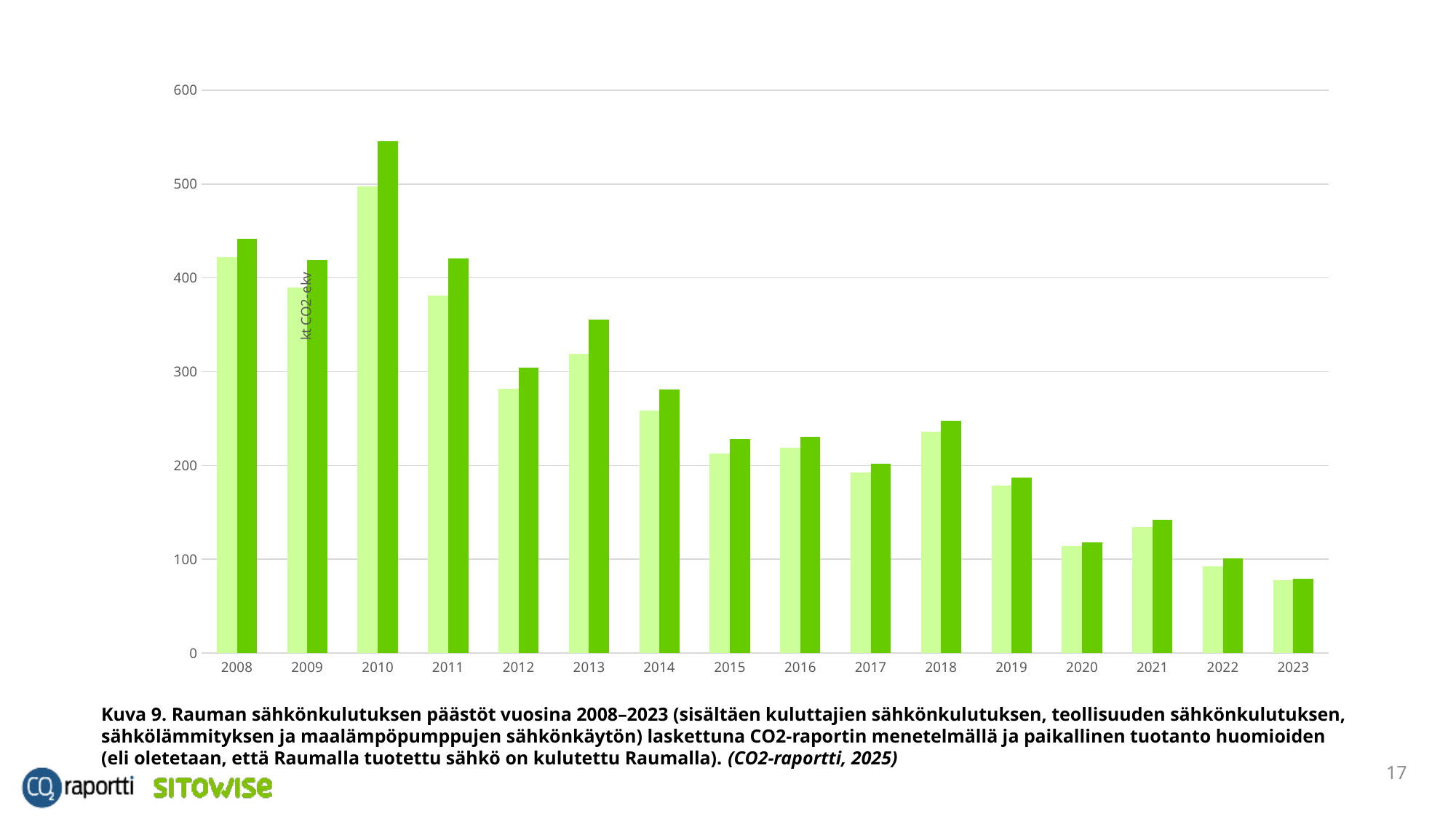
What kind of chart is shown on the slide? bar chart Is the value of the dark green bar for 2010 greater or less than 500? greater Do the values generally rise or fall from 2008 to 2023? fall Is the value of the light green bar for 2008 greater or less than 400? greater Which is larger, the light green bar for 2016 or the light green bar for 2017? 2016 How many years are shown on the x axis of the chart? 16 Is the value of the light green bar for 2019 greater or less than 200? less Which year has the highest bars in the chart? 2010 What unit is shown on the y axis of the chart? kt CO2-ekv Which year has the lowest bars in the chart? 2023